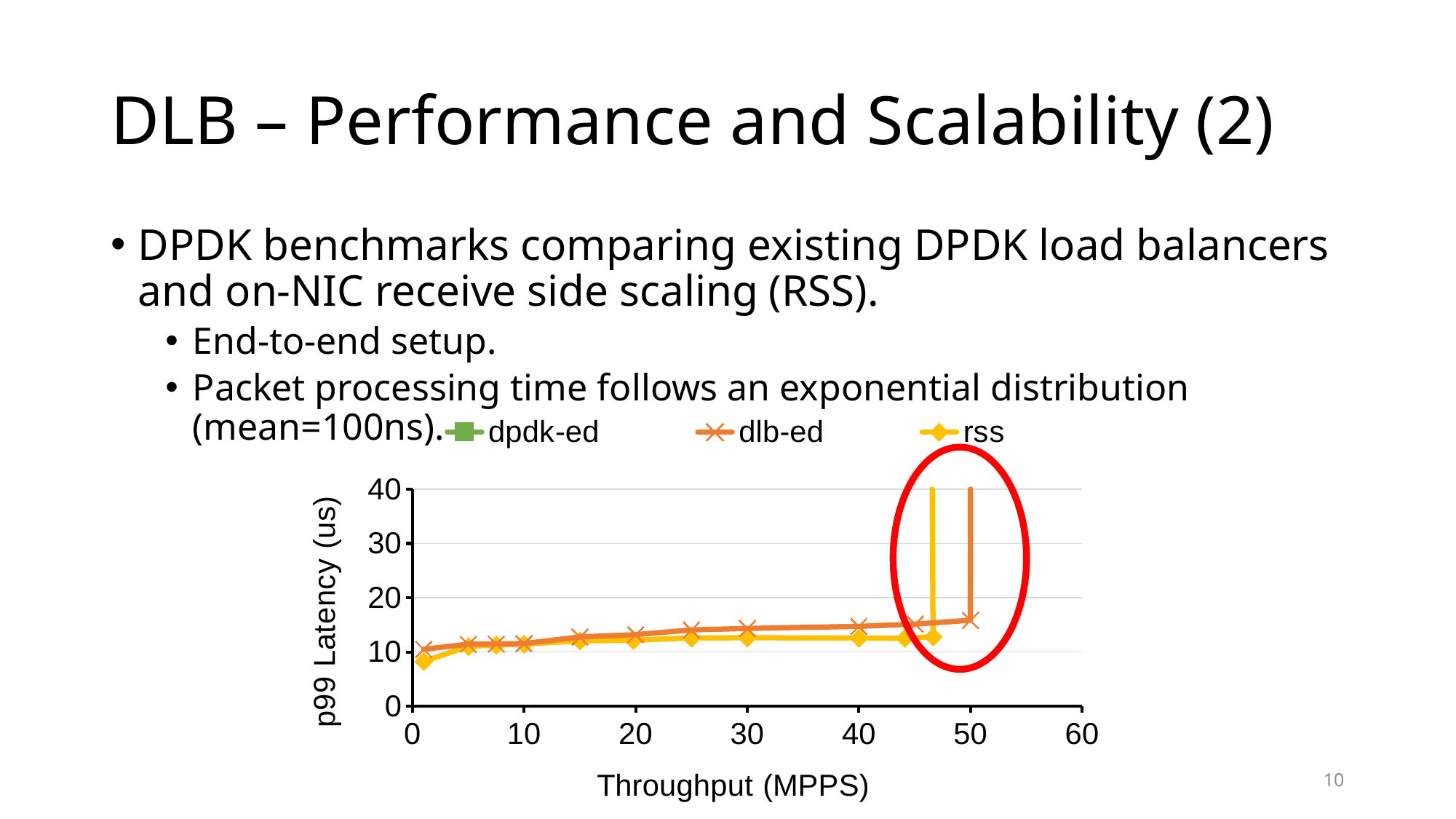
Is the p99 latency for dlb-ed at 30 MPPS greater or less than 20? less Does the p99 latency for dlb-ed rise or fall as throughput increases from 0 to 50 MPPS? rise Which series sustains a higher throughput before its latency spikes vertically, dlb-ed or rss? dlb-ed Is the p99 latency for rss at 1 MPPS greater or less than 10? less How many series does the chart legend list? 3 What kind of chart is shown on the slide? line chart Is the p99 latency for dlb-ed at 30 MPPS greater or less than 10? greater What are the series names listed in the chart legend? dpdk-ed, dlb-ed, rss At 40 MPPS, which series has the higher p99 latency, dlb-ed or rss? dlb-ed What is the title of the x axis of the chart? Throughput (MPPS) What is the highest value shown on the y axis of the chart? 40